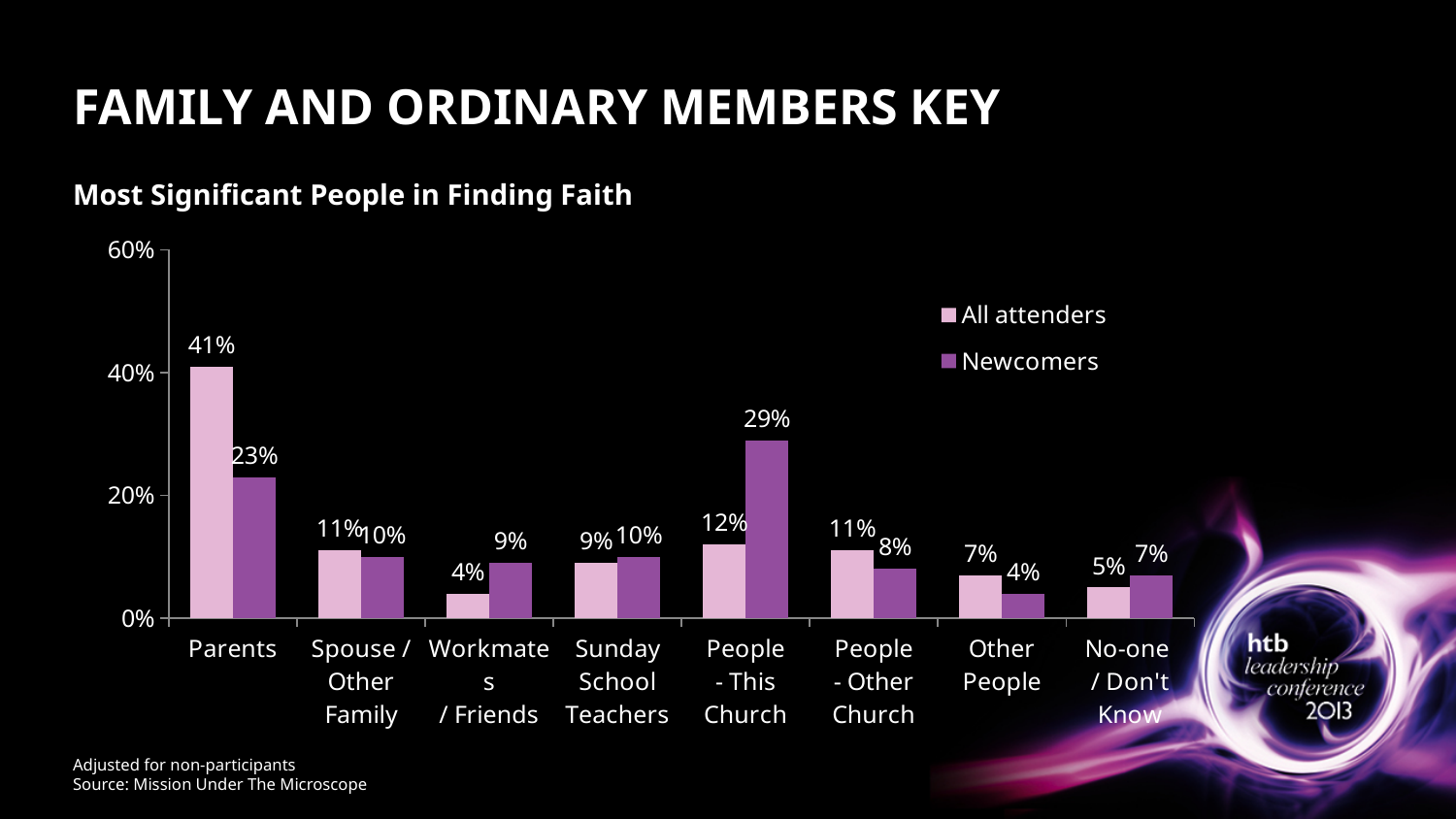
For People - This Church, which series has the larger value, All attenders or Newcomers? Newcomers Is the All attenders value for Parents greater or less than 40%? greater How many series does the legend list? 2 What percentage of all attenders named Parents as the most significant people in finding faith? 41% What is the title of the chart? Most Significant People in Finding Faith Which category has the highest value for Newcomers? People - This Church How many categories are shown on the x axis? 8 What kind of chart is shown on the slide? Bar chart What is the difference between the All attenders and Newcomers values for Parents? 18 percentage points What is the All attenders value for Workmates / Friends? 4% What is the Newcomers value for People - This Church? 29% Which category has the lowest value for All attenders? Workmates / Friends